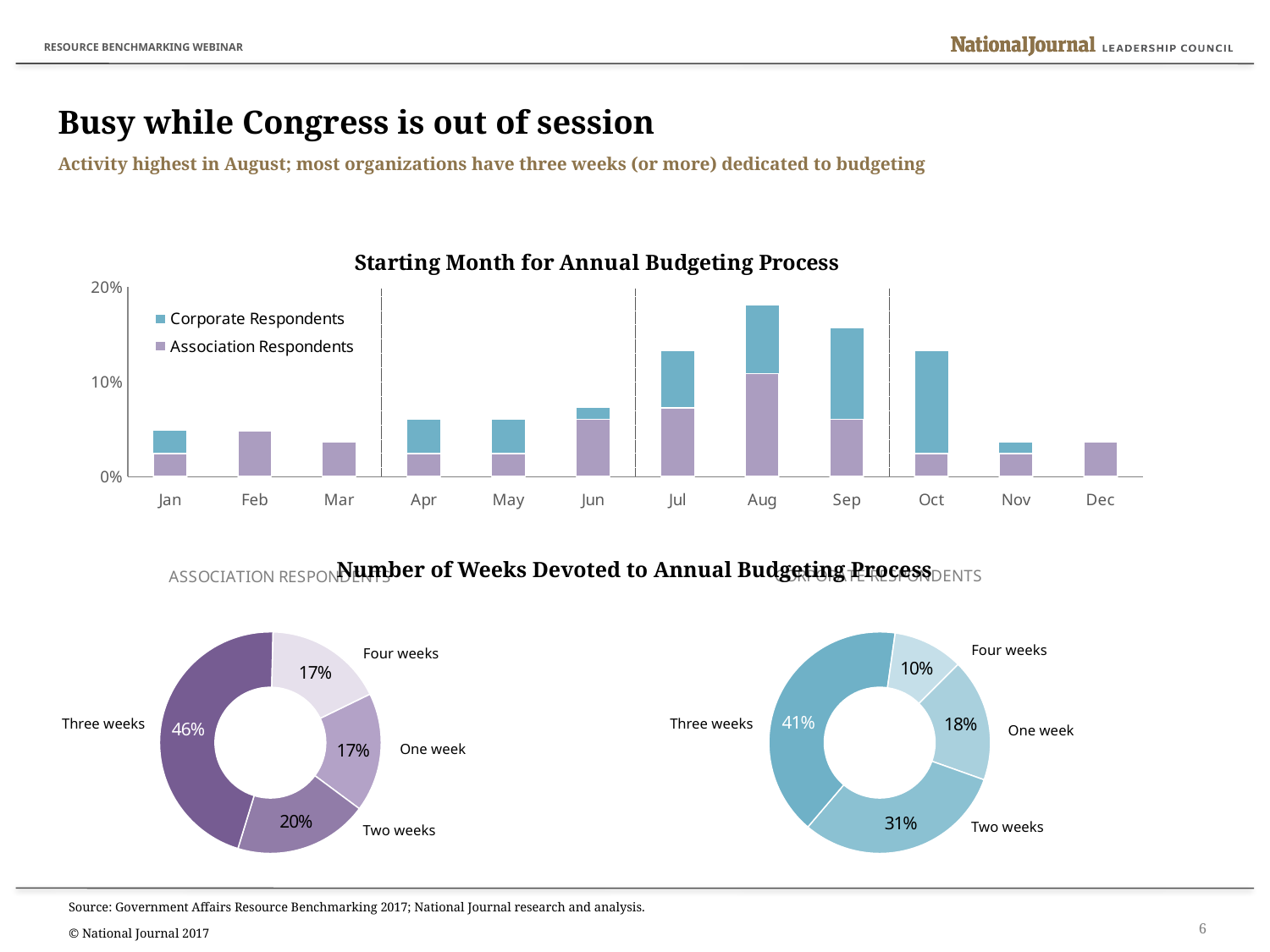
In the 'Starting Month for Annual Budgeting Process' chart, is the total stacked value for Aug greater or less than 10%? greater In the right donut chart (Corporate Respondents), which category has the smallest share? Four weeks In the 'Starting Month for Annual Budgeting Process' chart, how many series does the legend list? 2 In the right donut chart (Corporate Respondents), what share is Two weeks? 31% In the right donut chart (Corporate Respondents), which is larger: One week or Four weeks? One week In the left donut chart (Association Respondents) under 'Number of Weeks Devoted to Annual Budgeting Process', what share is Three weeks? 46% In the 'Starting Month for Annual Budgeting Process' chart, how many months are shown on the x axis? 12 What kind of chart is 'Starting Month for Annual Budgeting Process'? Stacked bar chart In the 'Starting Month for Annual Budgeting Process' chart, which month has the tallest stacked bar? Aug In the left donut chart (Association Respondents), what share is Two weeks? 20% What is the difference between the Three weeks share in the left donut chart (46%) and the Three weeks share in the right donut chart (41%)? 5% In the 'Starting Month for Annual Budgeting Process' chart, is the total stacked value for Feb greater or less than 10%? less